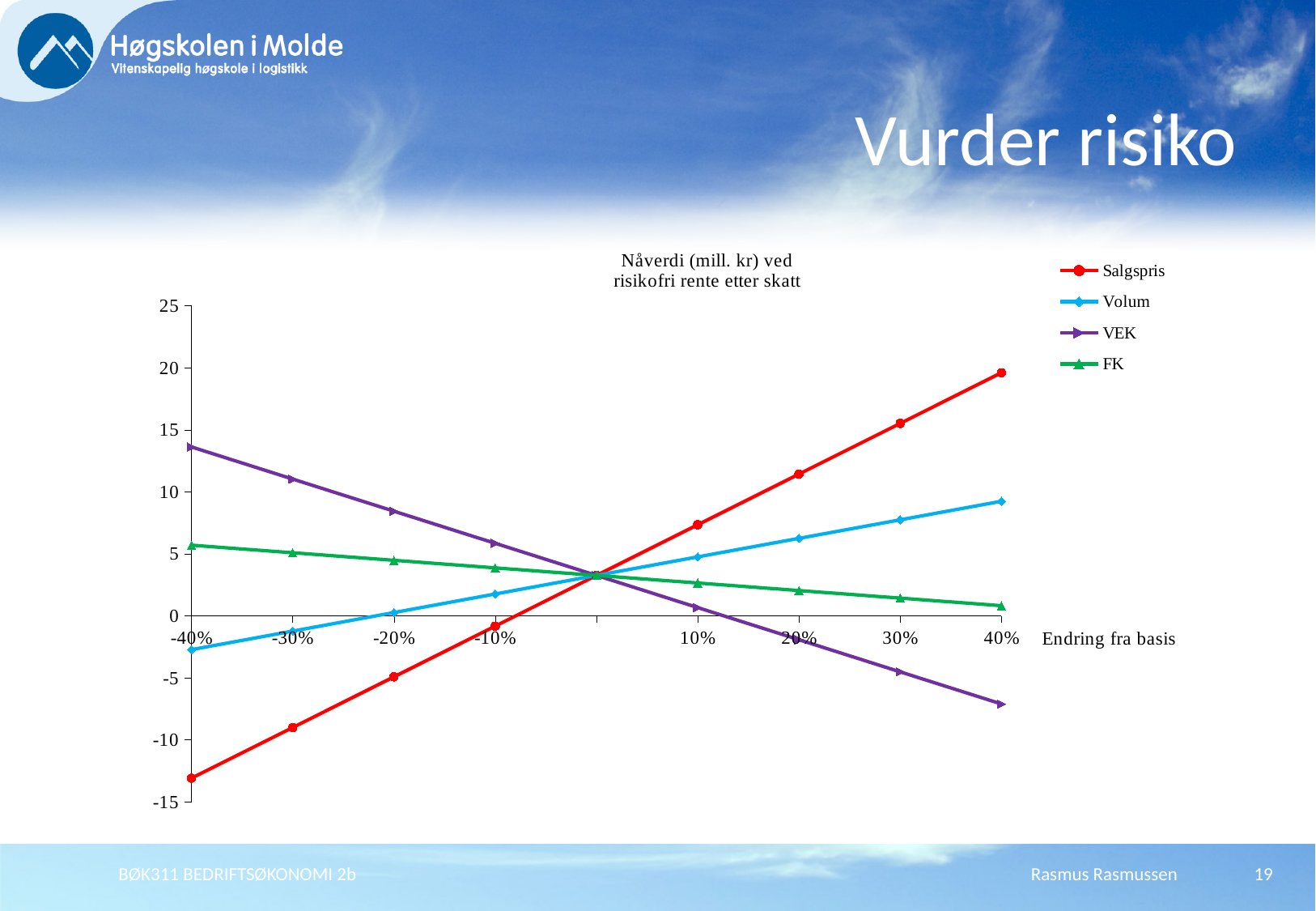
How many data points does each series have along the x axis? 9 Which series has the highest value at 40%? Salgspris What kind of chart is shown on the slide? Line chart What is the label on the x axis of the chart? Endring fra basis Which series has the lowest value at -40%? Salgspris Which series has the highest value at -40%? VEK Is the value for VEK at 40% greater or less than -5? less At 40%, which is larger: the value for Volum or the value for FK? Volum Is the value for Salgspris at 40% greater or less than 15? greater Does the VEK line rise or fall as the change from basis increases from -40% to 40%? Falls How many series does the legend list? 4 Does the Salgspris line rise or fall as the change from basis increases from -40% to 40%? Rises